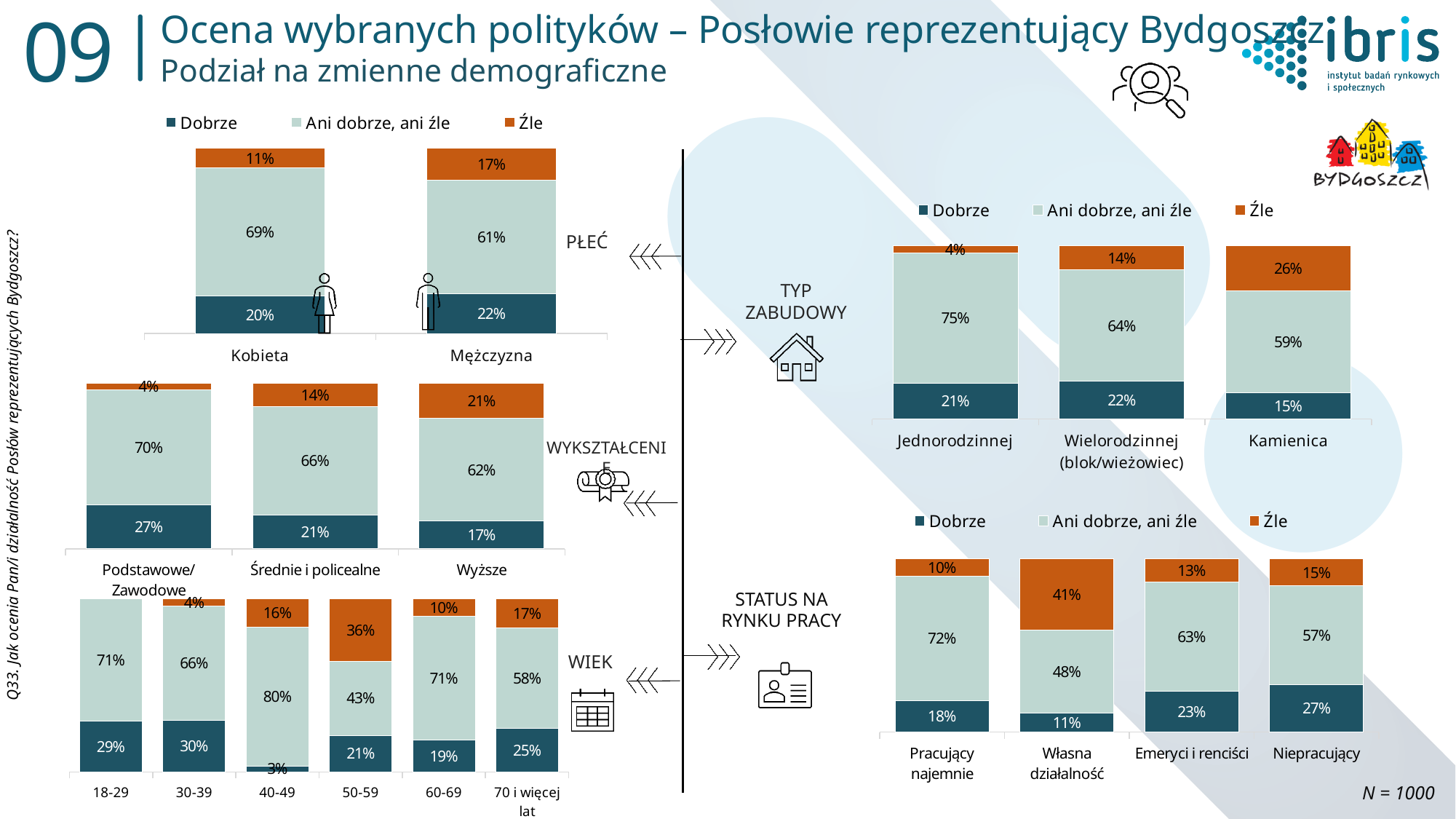
How many categories are shown in the WIEK chart? 6 In the STATUS NA RYNKU PRACY chart, what is the 'Źle' value for Własna działalność? 41% In the WIEK chart, which age group has the lowest 'Dobrze' value? 40-49 In the WIEK chart, what is the 'Ani dobrze, ani źle' value for the 40-49 group? 80% In the WYKSZTAŁCENIE chart, which category has the highest 'Dobrze' value? Podstawowe/Zawodowe In the PŁEĆ chart, what is the 'Źle' value for Mężczyzna? 17% In the WIEK chart, which age group has the highest 'Źle' value? 50-59 In the WYKSZTAŁCENIE chart, what is the difference between the 'Źle' values for Wyższe and Podstawowe/Zawodowe? 17 percentage points How many series does the legend of the STATUS NA RYNKU PRACY chart list? 3 In the TYP ZABUDOWY chart, what is the 'Źle' value for Kamienica? 26% In the TYP ZABUDOWY chart, which is larger: the 'Dobrze' value for Jednorodzinnej or for Kamienica? Jednorodzinnej In the PŁEĆ chart, what is the 'Dobrze' value for Kobieta? 20%